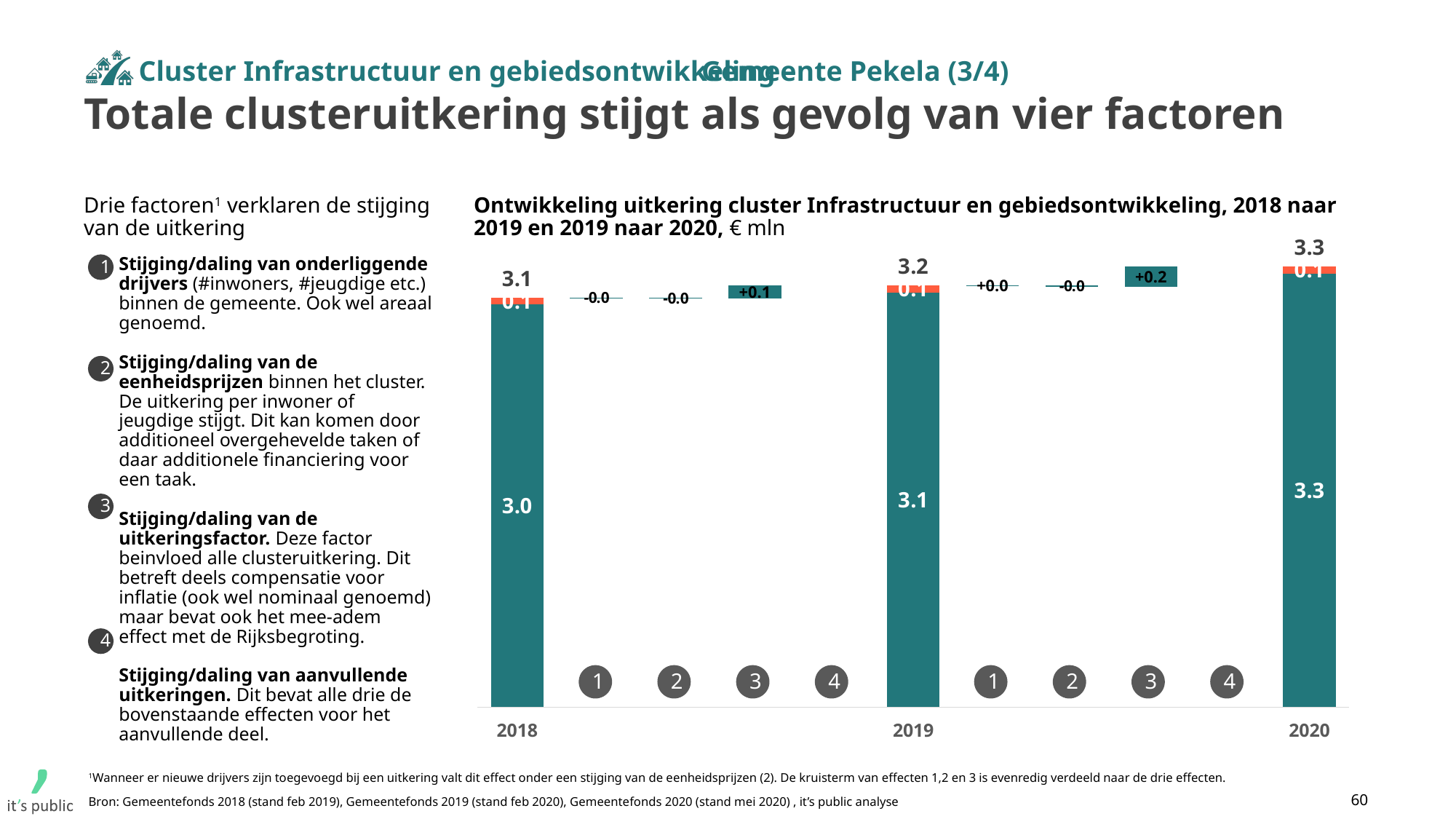
What is the value of the large teal segment of the 2019 bar? 3.1 What is the total value shown above the 2020 bar? 3.3 Do the total values rise or fall from 2018 to 2020? rise What is the value of the large teal segment of the 2018 bar? 3.0 What is the effect of factor 3 between 2018 and 2019? +0.1 Which year has the lowest total cluster payment? 2018 By how much does the total increase from 2018 to 2020? 0.2 Which year has the highest total cluster payment? 2020 What is the effect of factor 3 between 2019 and 2020? +0.2 What is the total value shown above the 2019 bar? 3.2 What is the total cluster payment shown above the 2018 bar? 3.1 In what unit are the values in the chart expressed? € mln